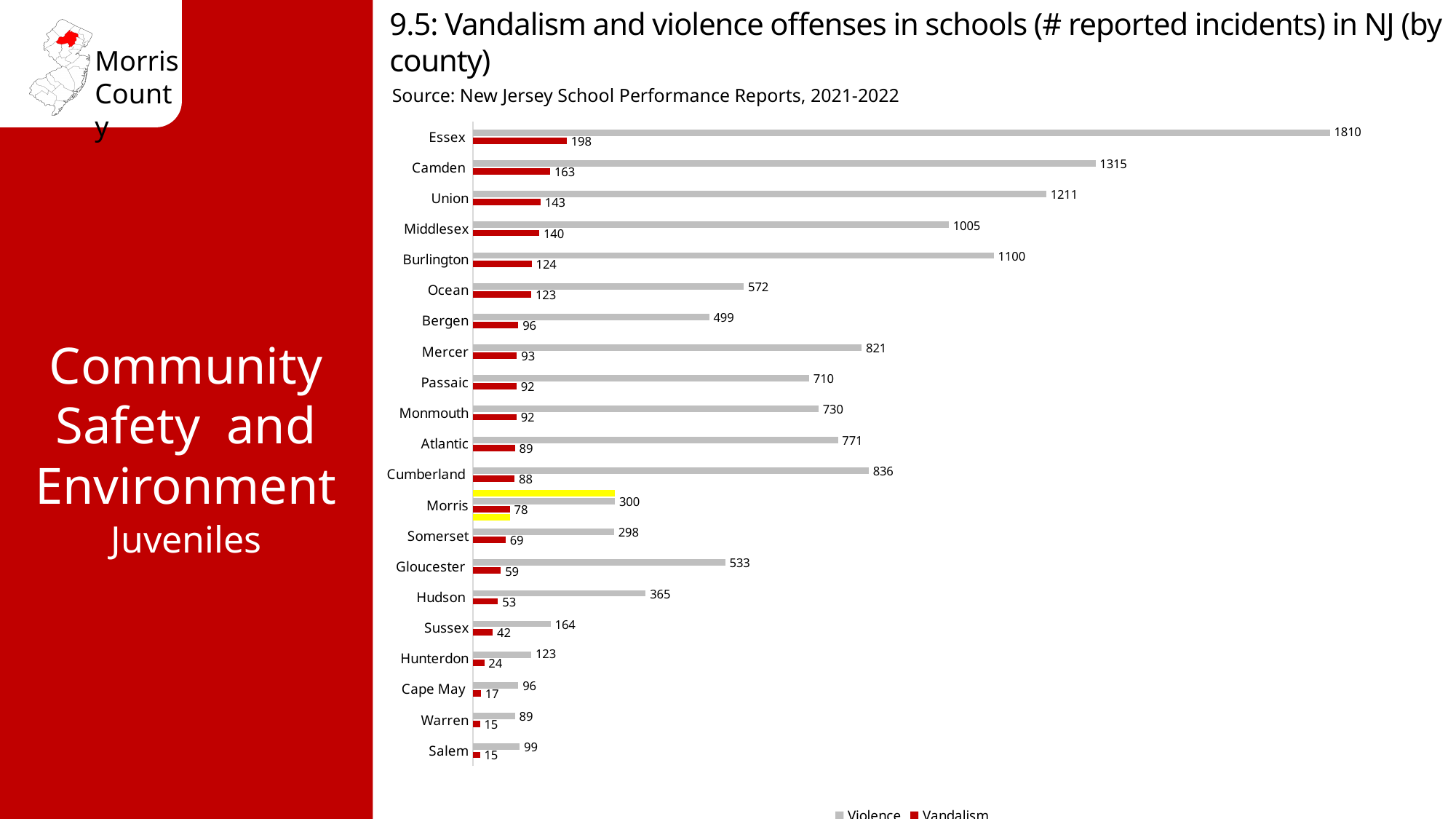
What is the number of reported violence incidents in Morris County? 300 Which county has the highest number of violence incidents? Essex What is the number of reported vandalism incidents in Morris County? 78 How many counties are shown in the chart? 21 What is the difference between violence and vandalism incidents in Morris County? 222 What is the number of violence incidents in Cumberland County? 836 What kind of chart is shown on the slide? Bar chart Which county has more violence incidents, Burlington or Middlesex? Burlington What colour represents the Vandalism series in the chart? Red What is the difference between the violence incidents in Essex and Camden? 495 How many series does the legend list? 2 Which county has the lowest number of violence incidents? Warren